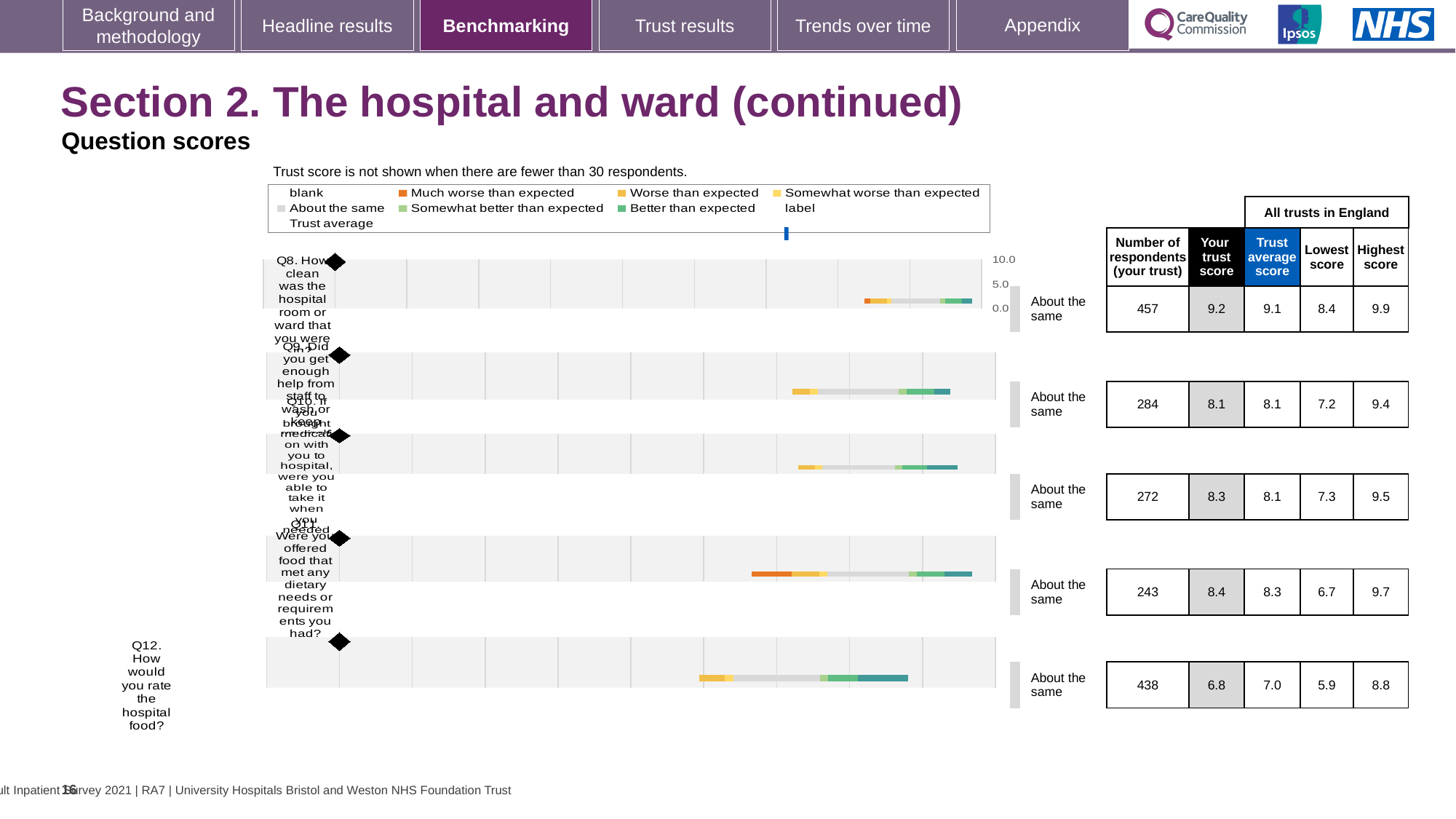
What benchmark category is shown for Q9 (enough help from staff to wash or keep clean)? About the same For Q12, what is the difference between the highest score and the lowest score across all trusts in England? 2.9 What is the 'Your trust score' for Q8 (how clean was the hospital room or ward)? 9.2 What kind of chart is used to show the question scores on this slide? bar chart How many questions (rows) are plotted in the chart? 5 For Q10, which is larger: your trust score or the trust average score? Your trust score For Q8, what is the difference between the highest score and the lowest score across all trusts in England? 1.5 What is the lowest score across all trusts in England for Q11 (offered food that met dietary needs)? 6.7 Which question has the lowest 'Your trust score'? Q12 Which question has the highest 'Your trust score'? Q8 What is the trust average score for Q9? 8.1 How many respondents from your trust answered Q12 (how would you rate the hospital food)? 438